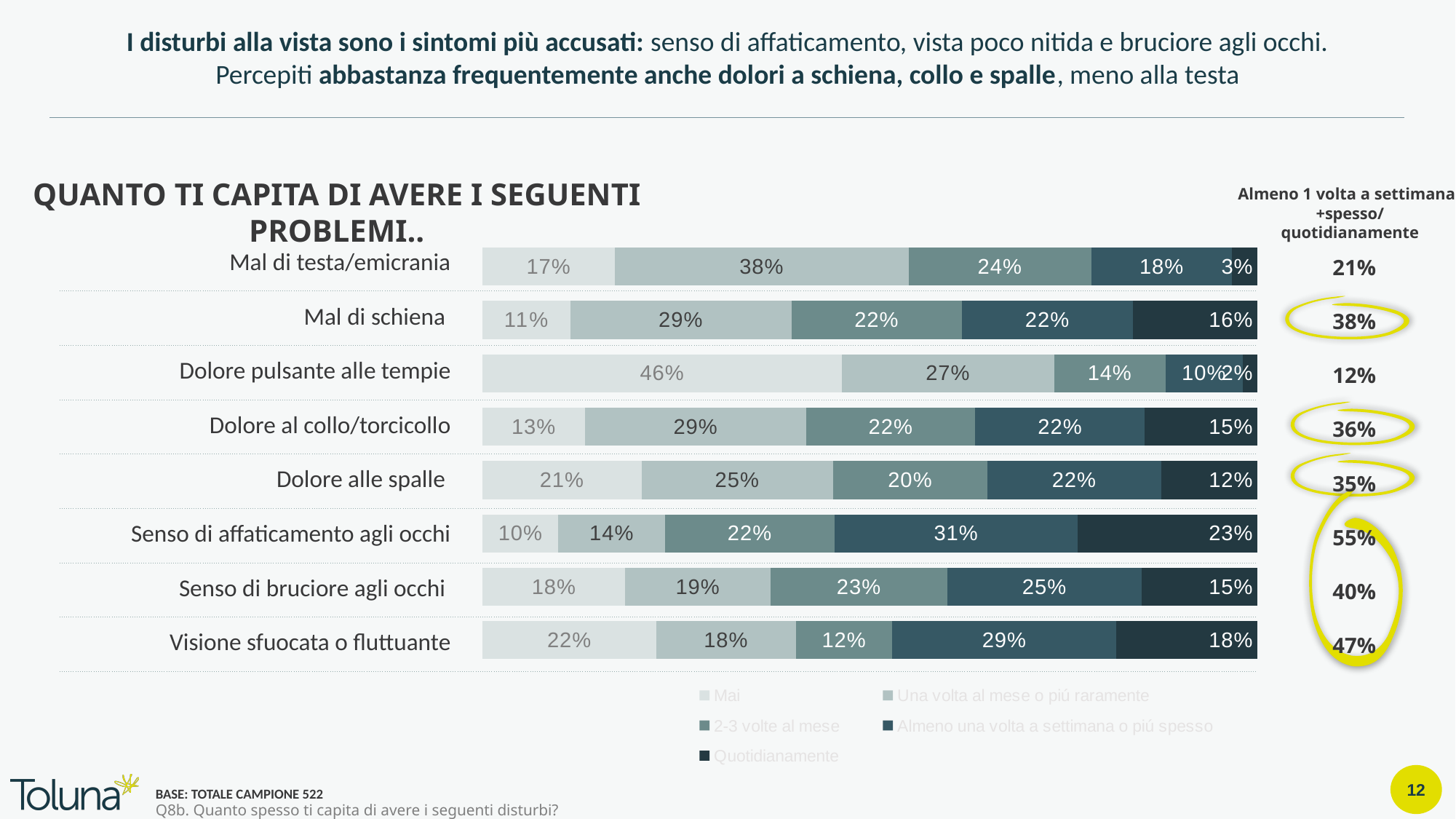
What is the difference between the 'Mai' value for 'Visione sfuocata o fluttuante' and the 'Mai' value for 'Senso di affaticamento agli occhi'? 12 percentage points What is the total of the stacked bar for 'Mal di testa/emicrania'? 100% What is the 'Una volta al mese o più raramente' value for 'Mal di schiena'? 29% How many series does the chart legend list? 5 What is the title of the chart? QUANTO TI CAPITA DI AVERE I SEGUENTI PROBLEMI.. How many problem categories are plotted in the chart? 8 What is the 'Mai' value for 'Dolore pulsante alle tempie'? 46% What kind of chart is shown on the slide? Stacked bar chart Which category has the highest 'Mai' value? Dolore pulsante alle tempie What is the 'Quotidianamente' value for 'Senso di affaticamento agli occhi'? 23% Which category has the lowest 'Quotidianamente' value? Dolore pulsante alle tempie Which is larger: the 'Almeno una volta a settimana o più spesso' value for 'Senso di affaticamento agli occhi' or for 'Mal di testa/emicrania'? Senso di affaticamento agli occhi